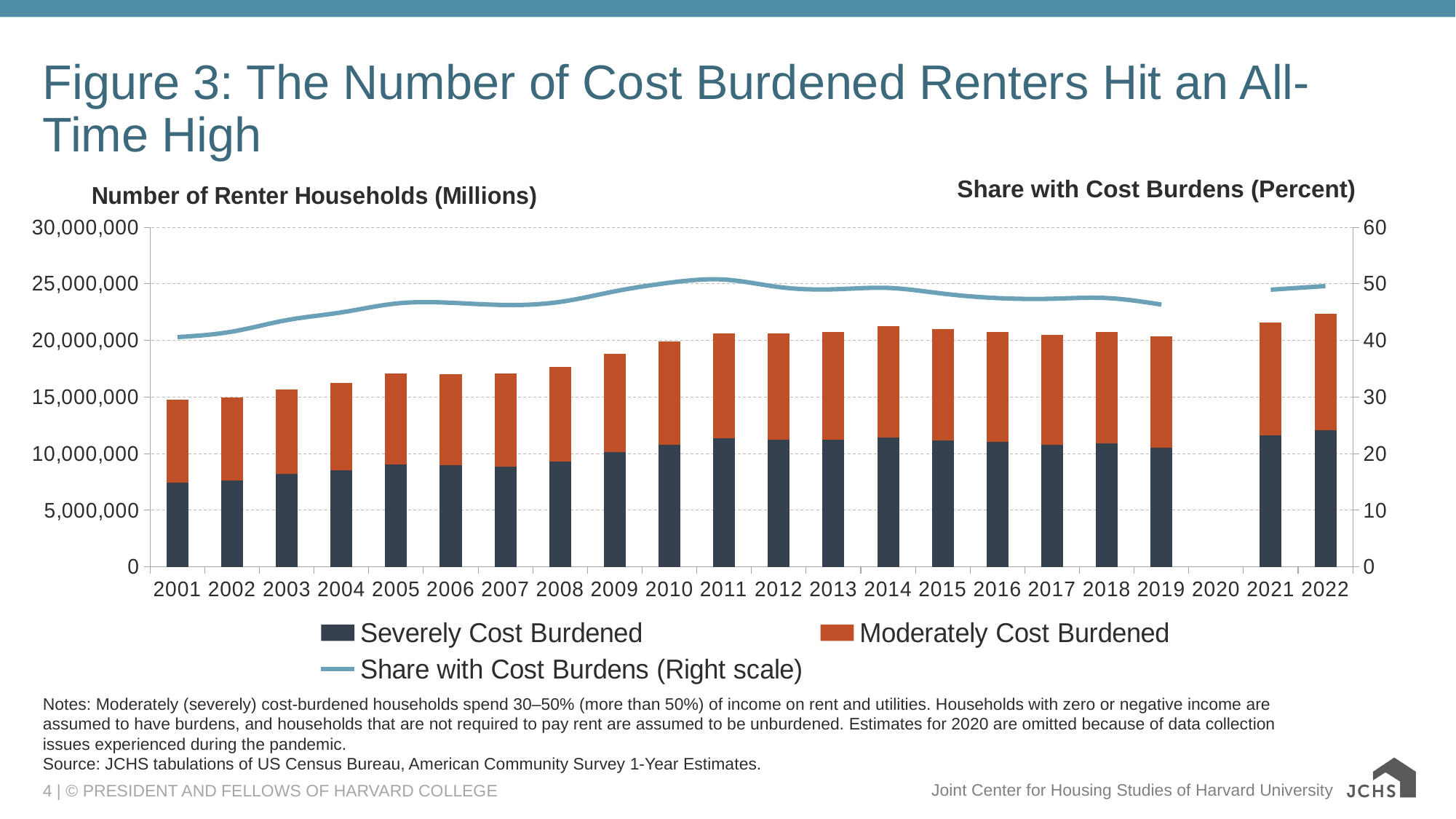
Which year has the larger total of cost burdened renter households, 2001 or 2022? 2022 Which year on the x axis has no bar plotted? 2020 Is the total number of cost burdened renter households in 2022 greater or less than 20,000,000? greater Does the Share with Cost Burdens line rise or fall from 2001 to 2011? rise Is the Share with Cost Burdens in 2019 greater or less than 50 percent? less Which year has the tallest stacked bar for total cost burdened renter households? 2022 What kind of chart is shown on the slide? A stacked bar chart with a line Is the Share with Cost Burdens in 2022 greater or less than 40 percent? greater How many series does the legend list? 3 What is the title of the right-hand axis? Share with Cost Burdens (Percent)